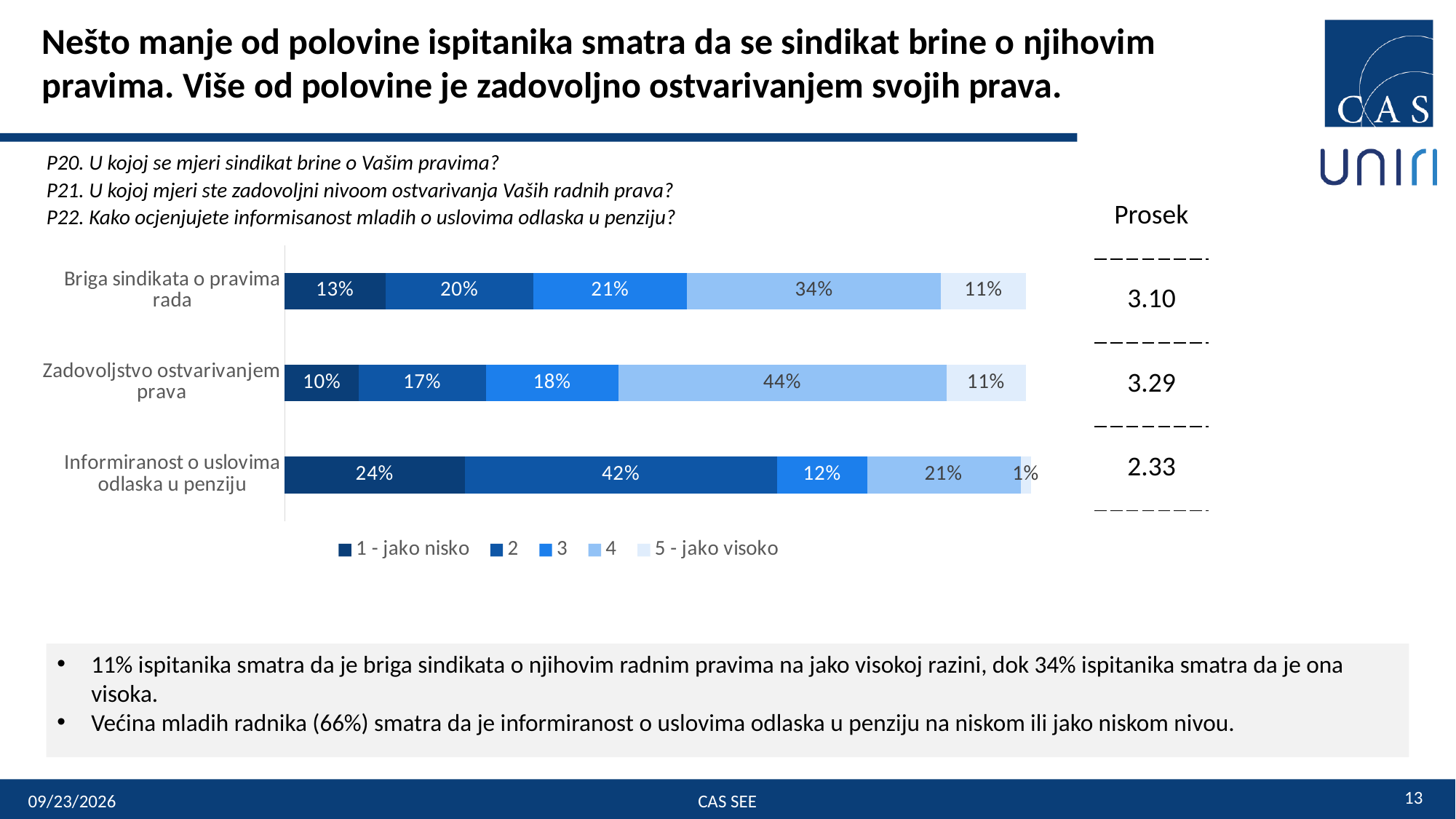
What percentage of respondents rated 'Informiranost o uslovima odlaska u penziju' as '1 - jako nisko'? 24% Which category has the lowest share of '5 - jako visoko' ratings? Informiranost o uslovima odlaska u penziju What percentage of respondents rated 'Zadovoljstvo ostvarivanjem prava' as 4? 44% What type of chart is shown on the slide? stacked bar chart Which category has the highest share of '1 - jako nisko' ratings? Informiranost o uslovima odlaska u penziju What percentage of respondents rated 'Informiranost o uslovima odlaska u penziju' as '5 - jako visoko'? 1% What is the label of the first legend entry? 1 - jako nisko How many series does the legend list? 5 How many categories (rows) does the chart show? 3 What is the difference between the '4' rating share for 'Zadovoljstvo ostvarivanjem prava' and for 'Briga sindikata o pravima rada'? 10% Which is larger: the '2' rating share for 'Informiranost o uslovima odlaska u penziju' or for 'Briga sindikata o pravima rada'? Informiranost o uslovima odlaska u penziju What percentage of respondents rated 'Briga sindikata o pravima rada' as 4? 34%